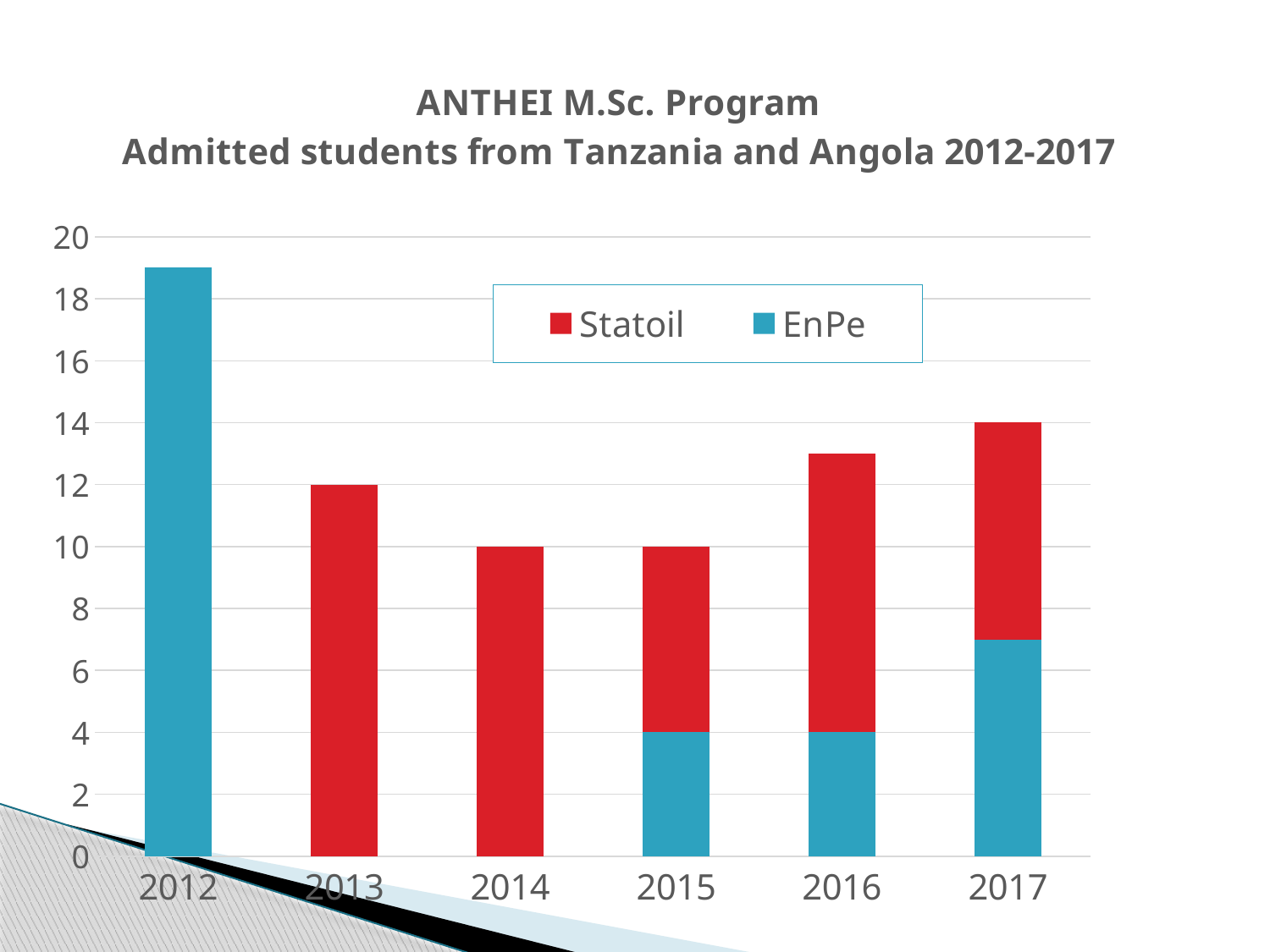
Which colour represents EnPe in the legend? blue How many series does the legend list? 2 Is the value for 2012 greater or less than 18? greater What is the total number of admitted students in 2014? 10 What is the total height of the stacked bar for 2017? 14 Which year has the larger total, 2013 or 2014? 2013 What is the EnPe value for 2015? 4 How many years are shown on the x axis? 6 What is the difference between the total for 2013 and the total for 2014? 2 What kind of chart is shown on the slide? stacked bar chart What is the total number of admitted students in 2013? 12 Which year has the highest total bar? 2012